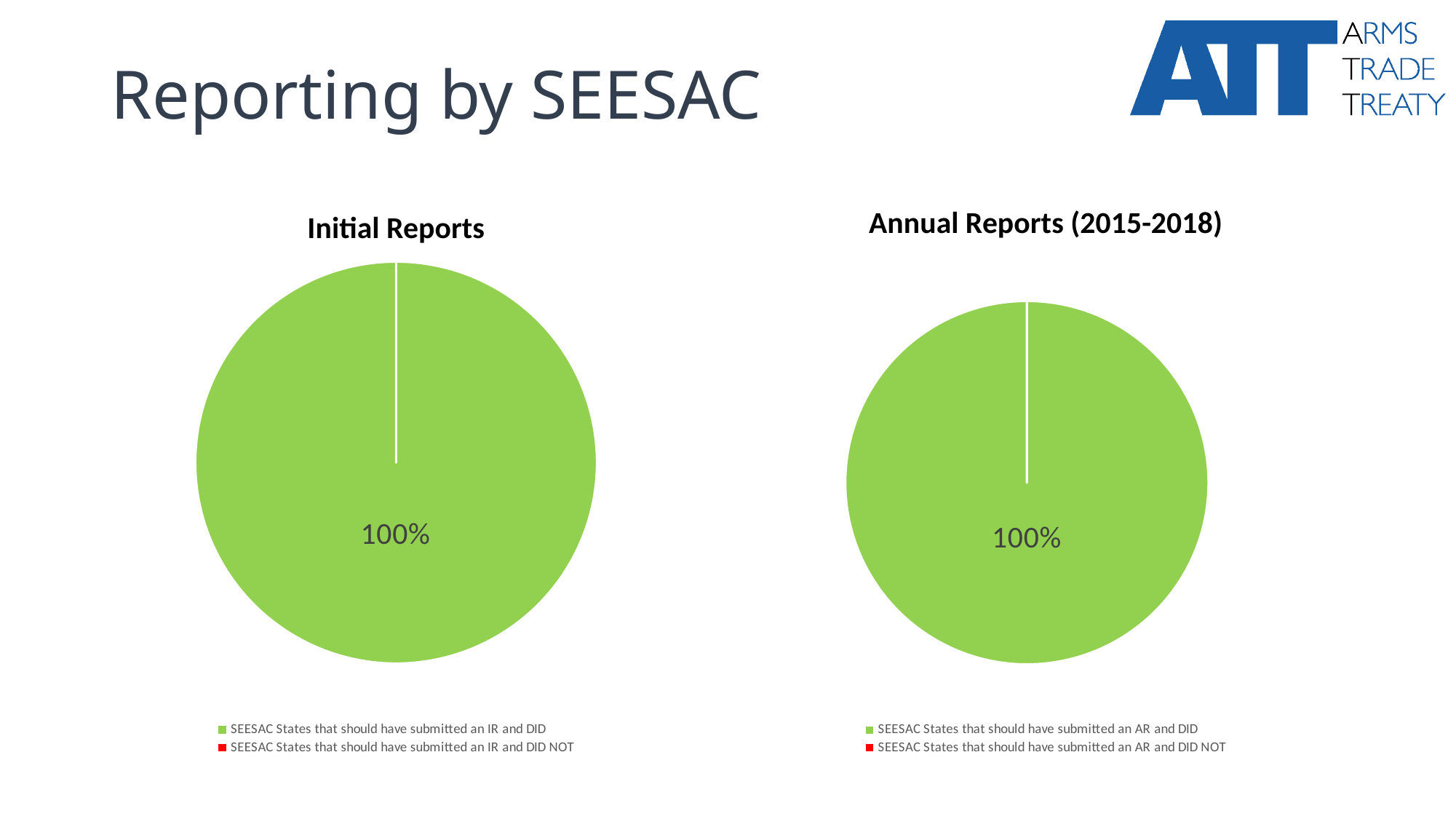
What kind of chart is the "Initial Reports" chart? pie chart In the "Initial Reports" chart, what colour is the slice labelled 100%? green How many entries does the legend of the "Initial Reports" chart list? 2 In the "Annual Reports (2015-2018)" chart, what share of the pie is labelled for SEESAC States that should have submitted an AR and DID? 100% In the "Annual Reports (2015-2018)" chart, which legend category is the largest slice? SEESAC States that should have submitted an AR and DID How many pie charts are shown on the slide? 2 What kind of chart is the "Annual Reports (2015-2018)" chart? pie chart In the "Initial Reports" chart, which legend category is the largest slice? SEESAC States that should have submitted an IR and DID In the "Initial Reports" chart, what share of the pie is labelled for SEESAC States that should have submitted an IR and DID? 100% What is the title of the chart on the right of the slide? Annual Reports (2015-2018) How many entries does the legend of the "Annual Reports (2015-2018)" chart list? 2